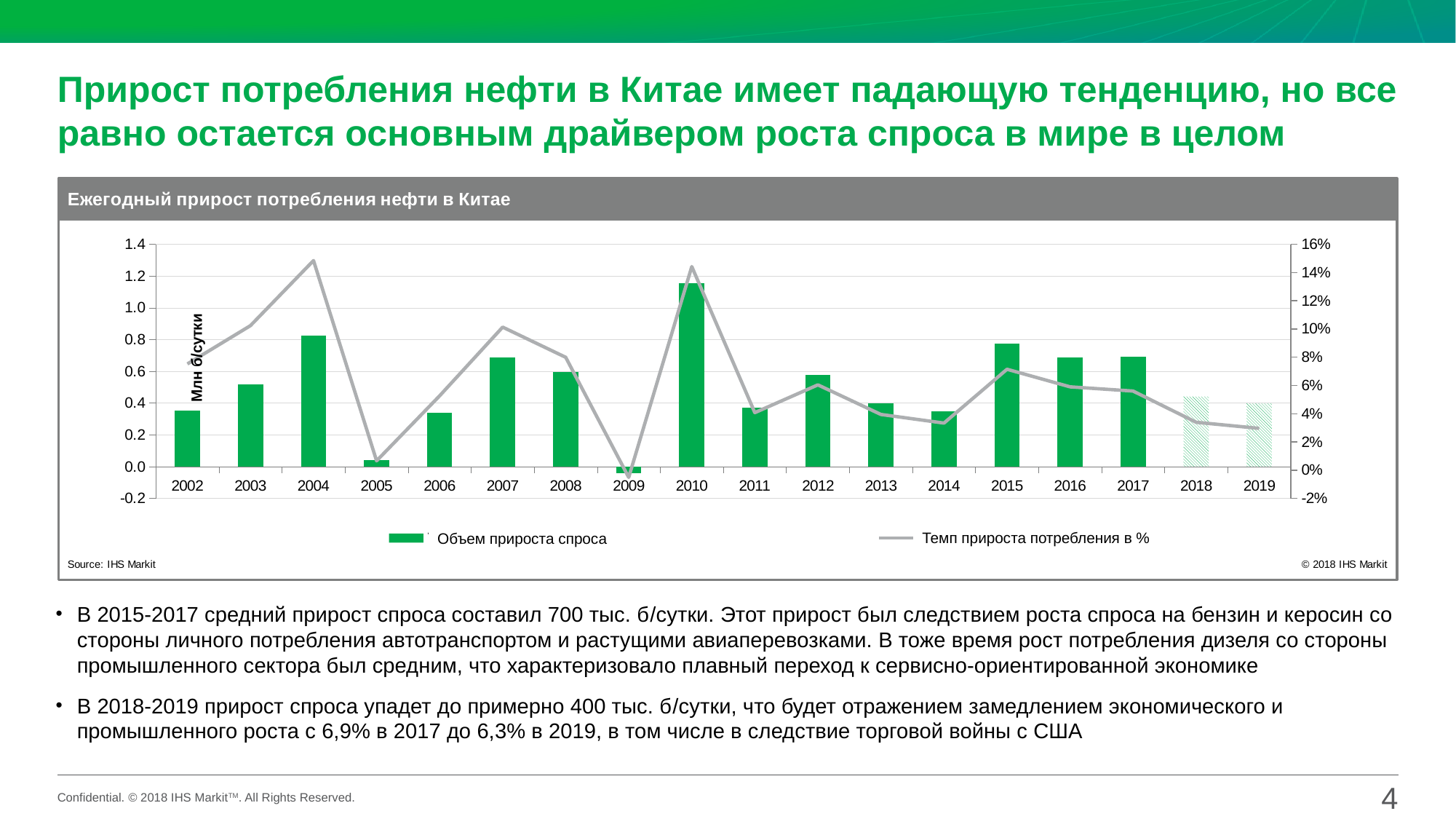
Which year has the lowest bar for Объем прироста спроса? 2009 How many years are shown on the x axis of the chart? 18 In which year is the line Темп прироста потребления в % at its lowest? 2009 How many series does the chart legend list? 2 What kind of chart is shown on the slide? A combination bar and line chart Which year has the larger bar, 2006 or 2007? 2007 Which year has the highest bar for Объем прироста спроса? 2010 What is the title of the chart? Ежегодный прирост потребления нефти в Китае Is the bar value for 2010 greater or less than 1.0? greater Is the bar value for 2005 greater or less than 0.2? less Is the bar value for 2015 greater or less than 0.6? greater Does the line Темп прироста потребления в % rise or fall from 2015 to 2019? Fall